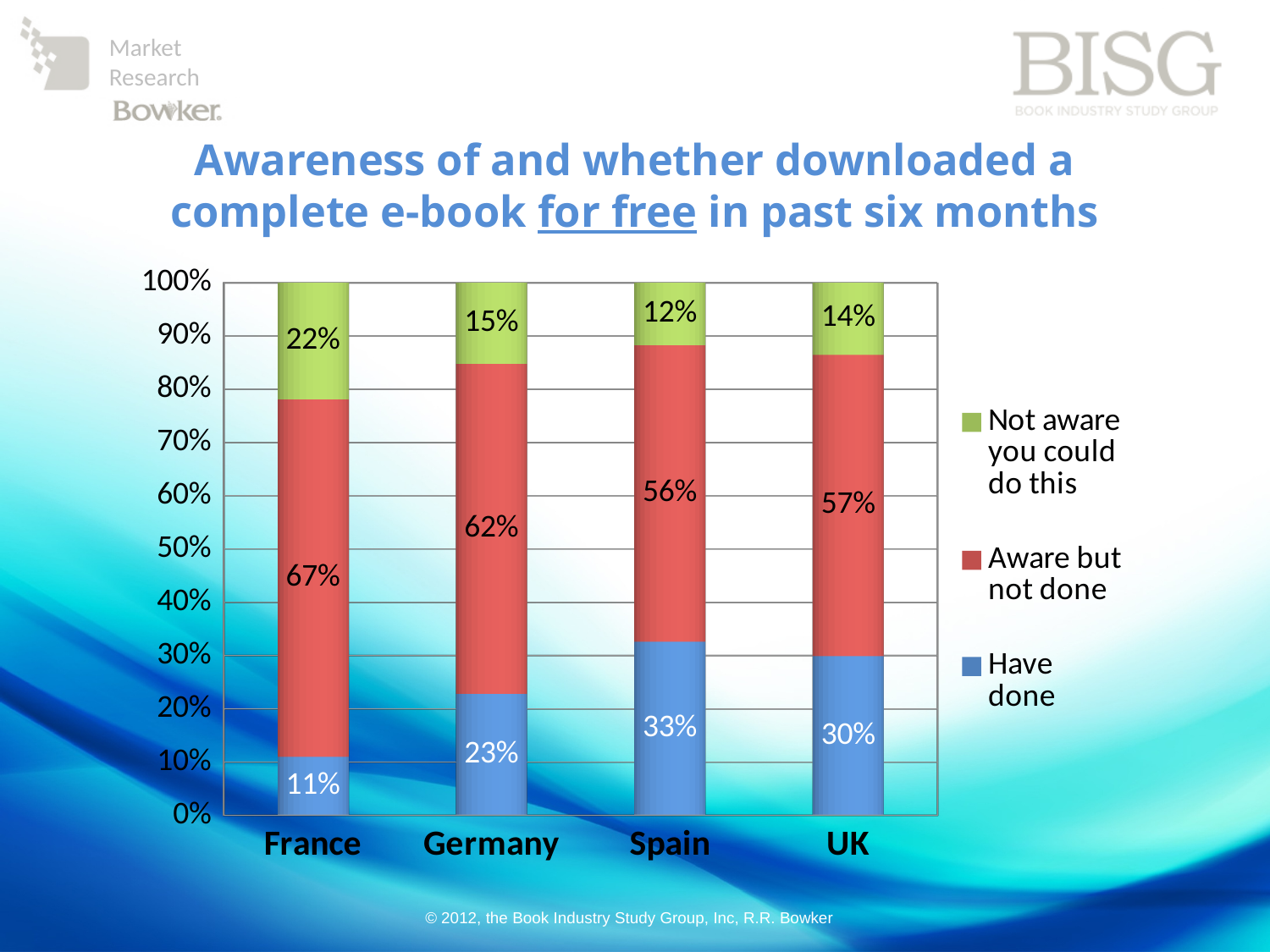
How many countries are shown on the x axis? 4 Which country has the lowest 'Have done' percentage? France How many series does the legend list? 3 Which country has the highest 'Not aware you could do this' percentage? France What percentage of respondents in Spain have done this (downloaded a complete e-book for free)? 33% Which colour represents 'Have done' in the chart? Blue What is the 'Not aware you could do this' value for France? 22% Which is larger, the 'Aware but not done' value for France or for Spain? France What kind of chart is shown on the slide? Stacked bar chart Which country has the highest 'Have done' percentage? Spain What is the 'Aware but not done' value for Germany? 62% What is the difference between the 'Have done' values for the UK and France? 19%